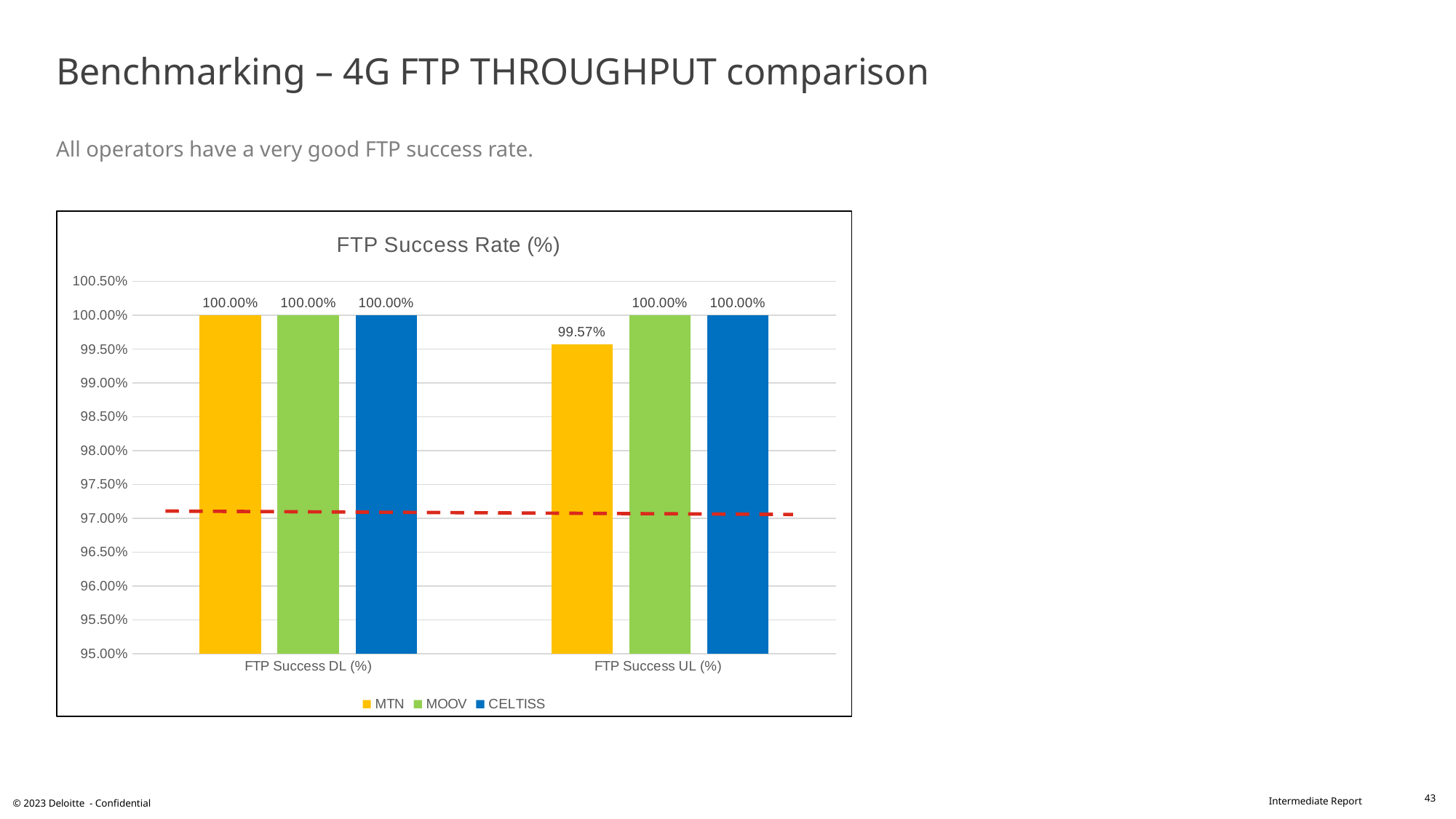
What kind of chart is shown on the slide? Bar chart What is the FTP Success UL (%) value for MTN? 99.57% How many series does the legend list? 3 How many categories are shown on the x axis? 2 Which is larger for MTN: FTP Success DL (%) or FTP Success UL (%)? FTP Success DL (%) What is the difference between CELTISS and MTN for FTP Success UL (%)? 0.43% What is the title of the chart? FTP Success Rate (%) Which colour represents MOOV in the chart? Green What is the FTP Success DL (%) value for MOOV? 100.00% Is the FTP Success UL (%) value for MTN greater or less than 99.00%? greater What is the FTP Success UL (%) value for CELTISS? 100.00% Which operator has the lowest FTP Success UL (%) value? MTN